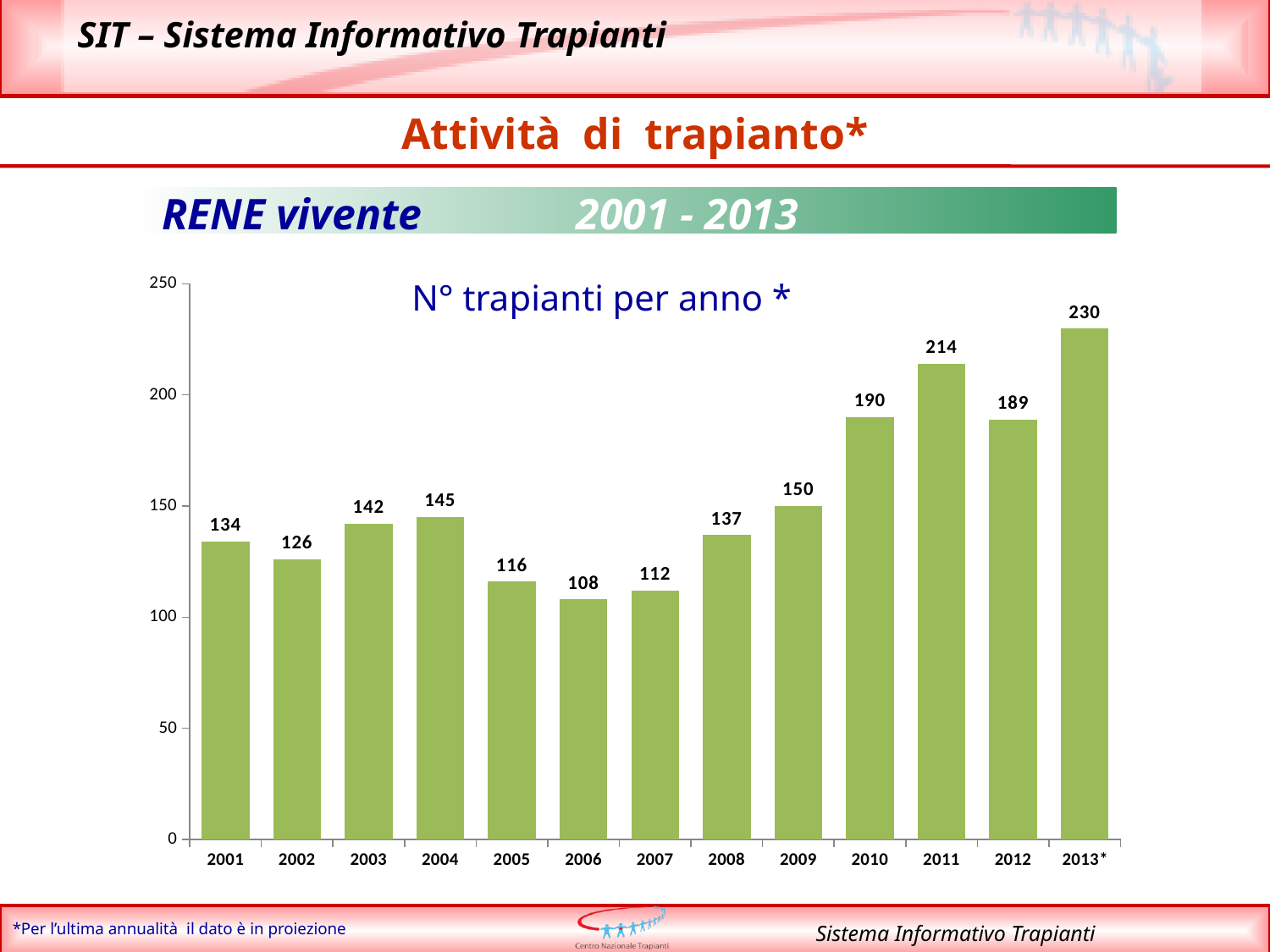
Which year has the lowest value? 2006 Which is larger, the value for 2010 or the value for 2012? 2010 Is the value for 2009 greater or less than 100? greater What is the difference between the values for 2013* and 2012? 41 What value is shown for 2011? 214 What is the title of the chart? N° trapianti per anno * What value is shown for 2006? 108 What is the number of transplants shown for 2001? 134 Which year has the highest value? 2013* How many years are shown on the x axis? 13 What is the difference between the values for 2004 and 2005? 29 What kind of chart is shown on the slide? bar chart